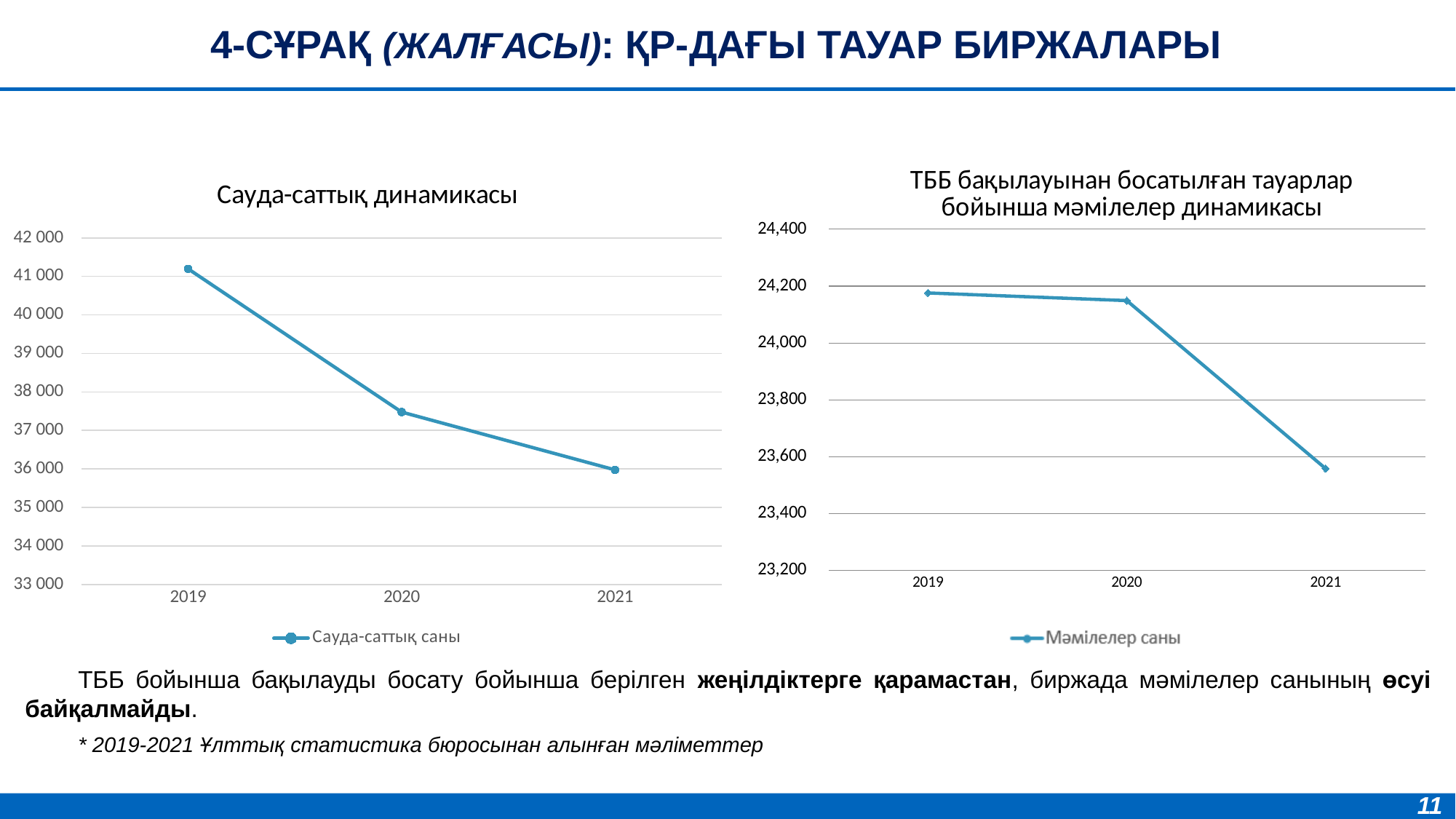
In the right chart "ТББ бақылауынан босатылған тауарлар бойынша мәмілелер динамикасы", do the values rise or fall from 2019 to 2021? fall In the right chart "ТББ бақылауынан босатылған тауарлар бойынша мәмілелер динамикасы", is the value for 2021 greater or less than 23,800? less In the left chart "Сауда-саттық динамикасы", is the value for 2019 greater or less than 40 000? greater In the left chart "Сауда-саттық динамикасы", how many years are plotted on the x axis? 3 In the left chart "Сауда-саттық динамикасы", which year has the lowest value? 2021 In the left chart "Сауда-саттық динамикасы", do the values rise or fall from 2019 to 2021? fall What kind of chart is the left chart titled "Сауда-саттық динамикасы"? line chart In the right chart "ТББ бақылауынан босатылған тауарлар бойынша мәмілелер динамикасы", which year has the lowest value? 2021 In the left chart "Сауда-саттық динамикасы", which year has the highest value? 2019 What kind of chart is the right chart titled "ТББ бақылауынан босатылған тауарлар бойынша мәмілелер динамикасы"? line chart In the right chart "ТББ бақылауынан босатылған тауарлар бойынша мәмілелер динамикасы", how many series does the legend list? 1 What is the legend entry of the left chart "Сауда-саттық динамикасы"? Сауда-саттық саны